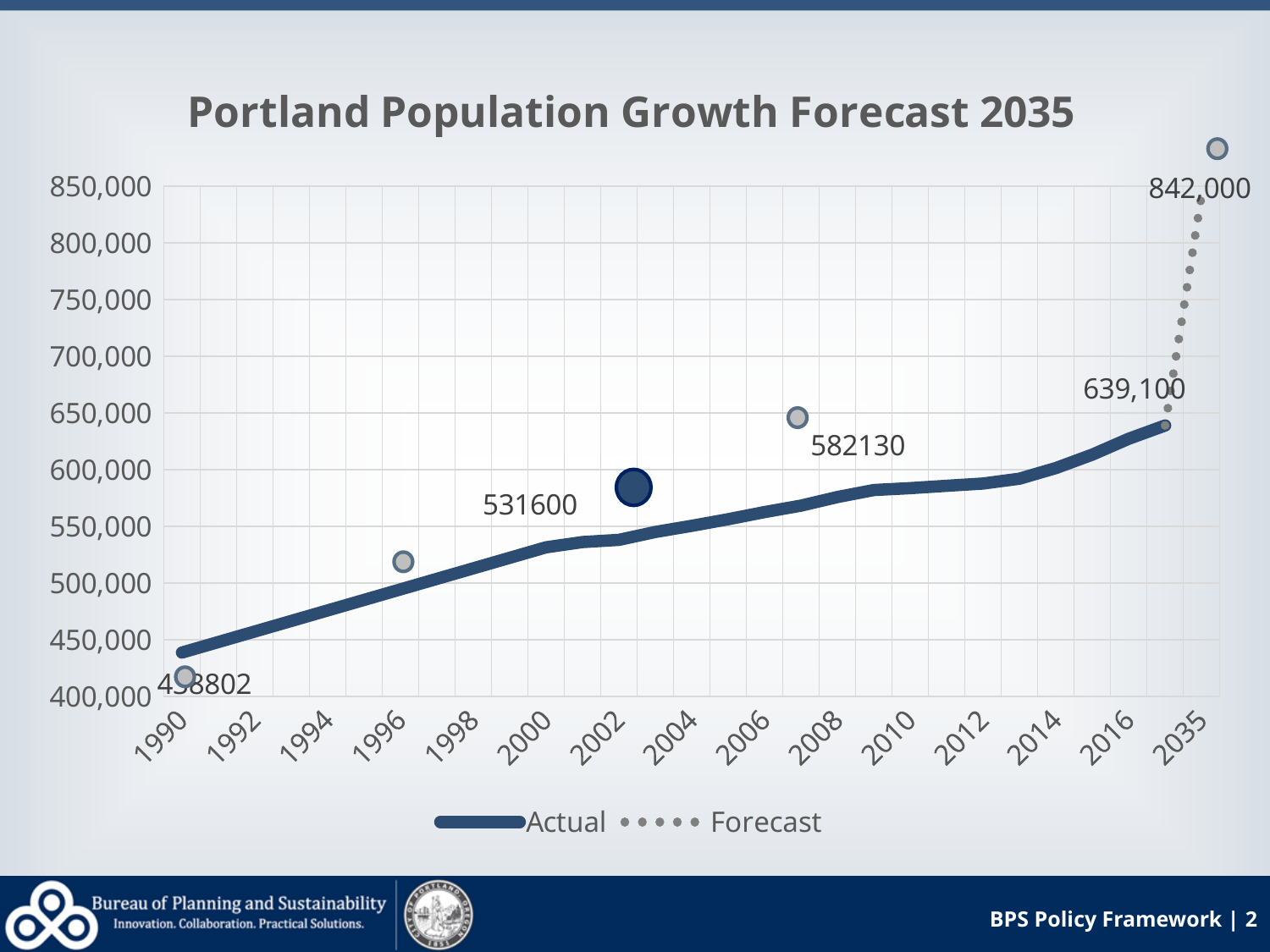
Is the value for 1990 greater or less than 450,000? less What are the two series named in the legend? Actual and Forecast Do the population values generally rise or fall from 1990 to 2035? rise What is the title of the chart? Portland Population Growth Forecast 2035 Which year on the x axis has the highest population value? 2035 What kind of chart is shown on the slide? line chart How many series does the legend list? 2 Is the value for 2010 greater or less than 550,000? greater What is the difference between the 2035 forecast value (842,000) and the last labelled actual value (639,100)? 202,900 Which year on the x axis has the lowest population value? 1990 What is the last labelled value on the Actual line, just before the forecast begins? 639,100 What is the forecast population value labelled for 2035? 842,000